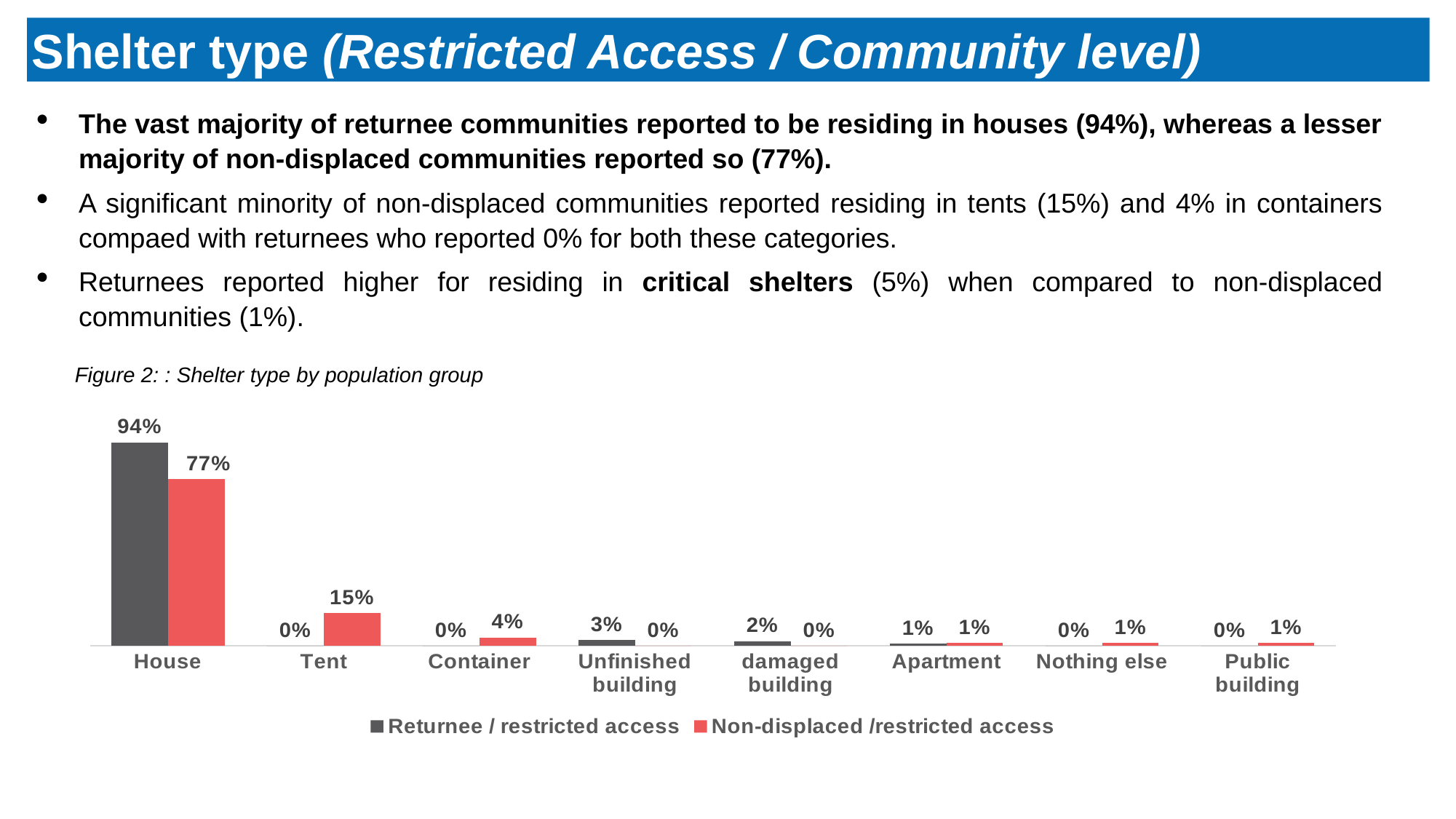
What is the caption of the figure on the slide? Figure 2: : Shelter type by population group How many series does the legend list? 2 Which colour represents the Non-displaced / restricted access series? Red What percentage of Non-displaced / restricted access communities reported residing in a Tent? 15% What is the value for Unfinished building in the Returnee / restricted access series? 3% Which shelter type has the highest value for Non-displaced / restricted access? House What kind of chart is shown in Figure 2? Bar chart Which is larger for damaged building: the Returnee / restricted access value or the Non-displaced / restricted access value? Returnee / restricted access What is the difference between the Returnee and Non-displaced values for House? 17% What percentage of Returnee / restricted access communities reported residing in a House? 94% How many shelter type categories are shown on the x axis? 8 What is the value for Container in the Non-displaced / restricted access series? 4%